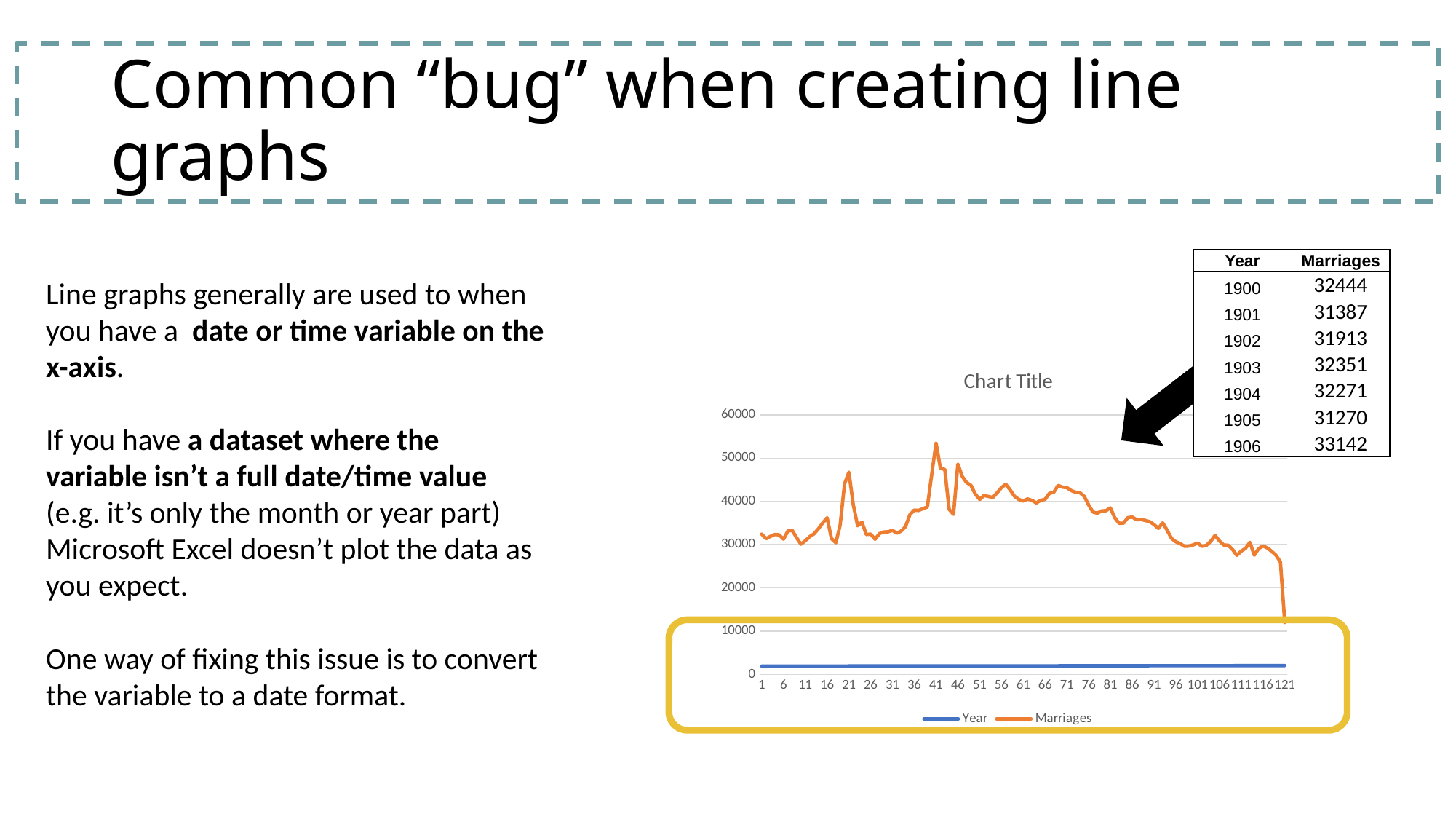
Is the Marriages value at x-axis point 1 greater or less than 40000? less What type of chart is shown on the slide? line chart What are the two series named in the chart's legend? Year and Marriages Is the Marriages value at x-axis point 121 greater or less than 20000? less How many series does the chart's legend list? 2 Is the Marriages value at x-axis point 41 greater or less than 50000? greater What is the last label shown on the chart's x-axis? 121 What is the title shown above the chart? Chart Title What is the highest value labelled on the chart's y-axis? 60000 Does the Marriages line rise or fall between x-axis points 71 and 121? fall Which series is plotted higher on the chart, Year or Marriages? Marriages